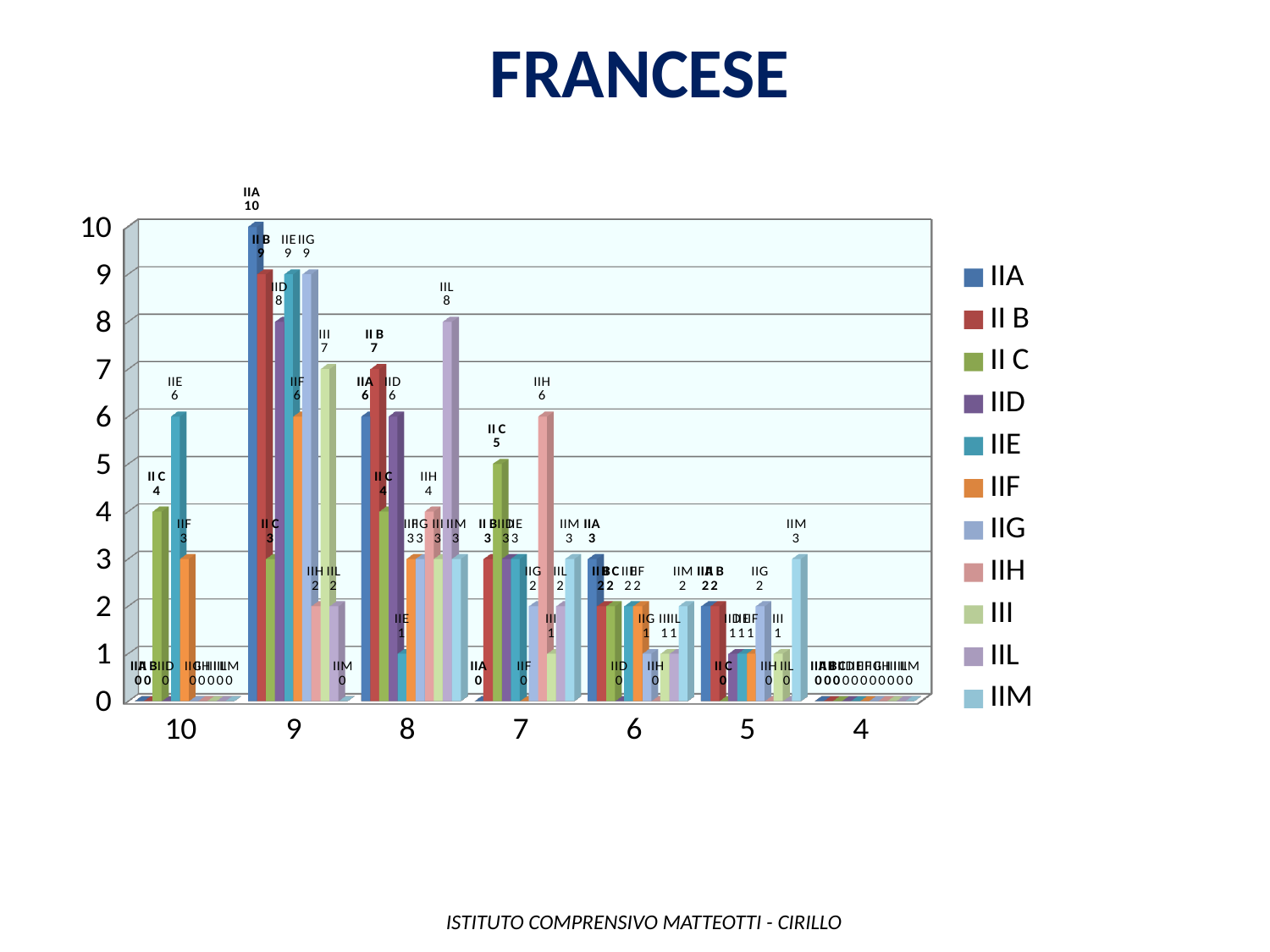
What kind of chart is shown on the slide? bar chart What is the value for IIH in category 7? 6 What is the value for IIE in category 10? 6 How many series does the legend list? 11 What is the value for IIM in category 5? 3 How many categories are shown on the x axis? 7 What is the value for IIL in category 8? 8 What is the value for IIA in category 9? 10 In category 10, which is larger, the value for IIE or the value for IIF? IIE Which series has the highest value in category 9? IIA What is the title of the chart? FRANCESE What is the difference between the values for IIA and II B in category 9? 1